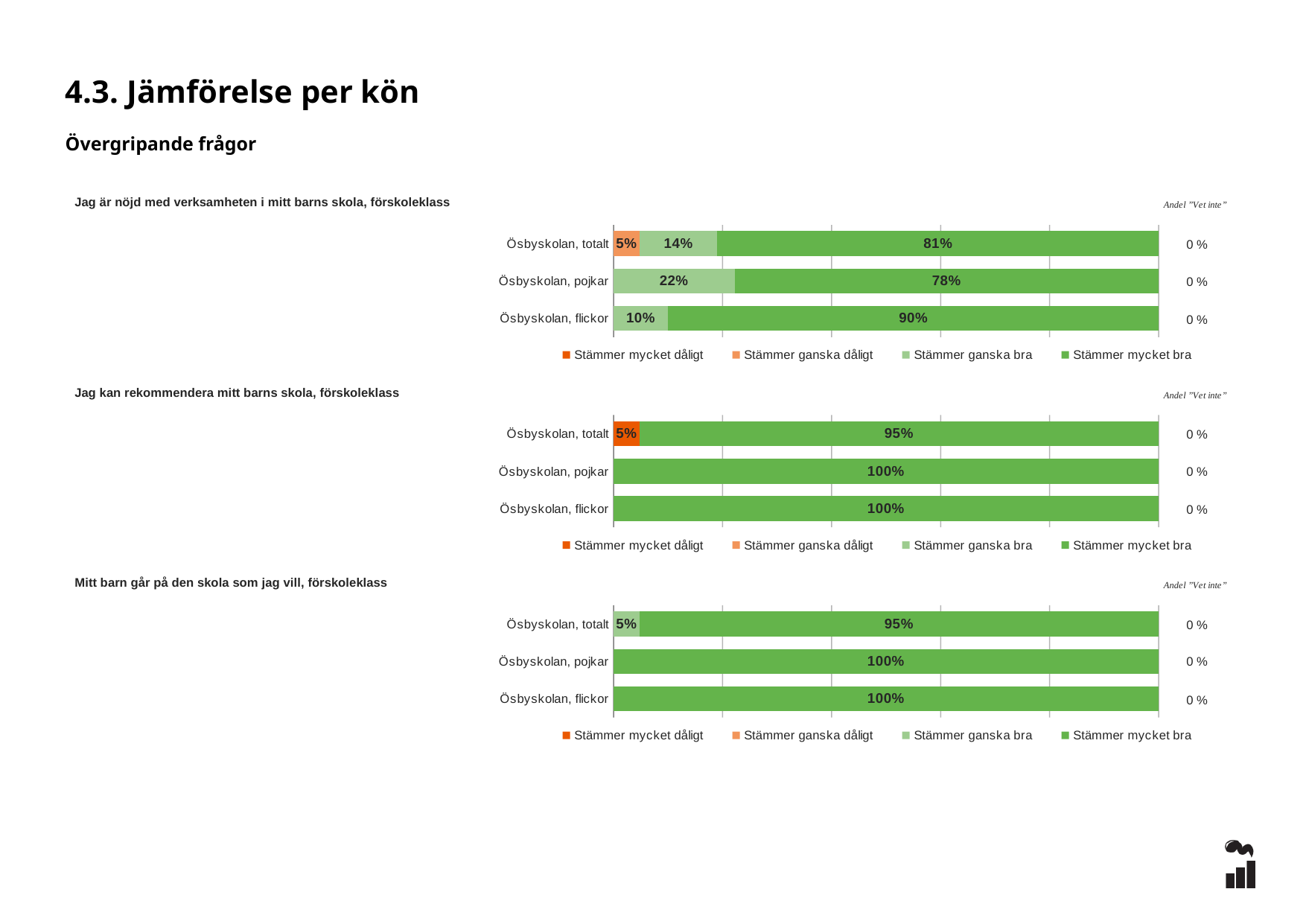
What kind of chart is 'Jag kan rekommendera mitt barns skola, förskoleklass'? Stacked bar chart In the chart 'Jag kan rekommendera mitt barns skola, förskoleklass', which is larger: the 'Stämmer mycket bra' value for Ösbyskolan, totalt or for Ösbyskolan, flickor? Ösbyskolan, flickor In the chart 'Jag är nöjd med verksamheten i mitt barns skola, förskoleklass', what is the difference between the 'Stämmer mycket bra' values for Ösbyskolan, flickor and Ösbyskolan, pojkar? 12% In the chart 'Jag kan rekommendera mitt barns skola, förskoleklass', what is the 'Stämmer mycket dåligt' value for Ösbyskolan, totalt? 5% How many series does the legend list for the chart 'Jag är nöjd med verksamheten i mitt barns skola, förskoleklass'? 4 In the chart 'Jag är nöjd med verksamheten i mitt barns skola, förskoleklass', what is the 'Stämmer ganska dåligt' value for Ösbyskolan, totalt? 5% In the chart 'Jag kan rekommendera mitt barns skola, förskoleklass', what is the 'Stämmer mycket bra' value for Ösbyskolan, pojkar? 100% In the chart 'Mitt barn går på den skola som jag vill, förskoleklass', what is the 'Stämmer mycket bra' value for Ösbyskolan, totalt? 95% In the chart 'Jag är nöjd med verksamheten i mitt barns skola, förskoleklass', what is the 'Stämmer mycket bra' value for Ösbyskolan, flickor? 90% In the chart 'Jag är nöjd med verksamheten i mitt barns skola, förskoleklass', what is the 'Stämmer ganska bra' value for Ösbyskolan, pojkar? 22% In the chart 'Jag är nöjd med verksamheten i mitt barns skola, förskoleklass', which category has the highest 'Stämmer mycket bra' value? Ösbyskolan, flickor How many categories are shown in the chart 'Mitt barn går på den skola som jag vill, förskoleklass'? 3